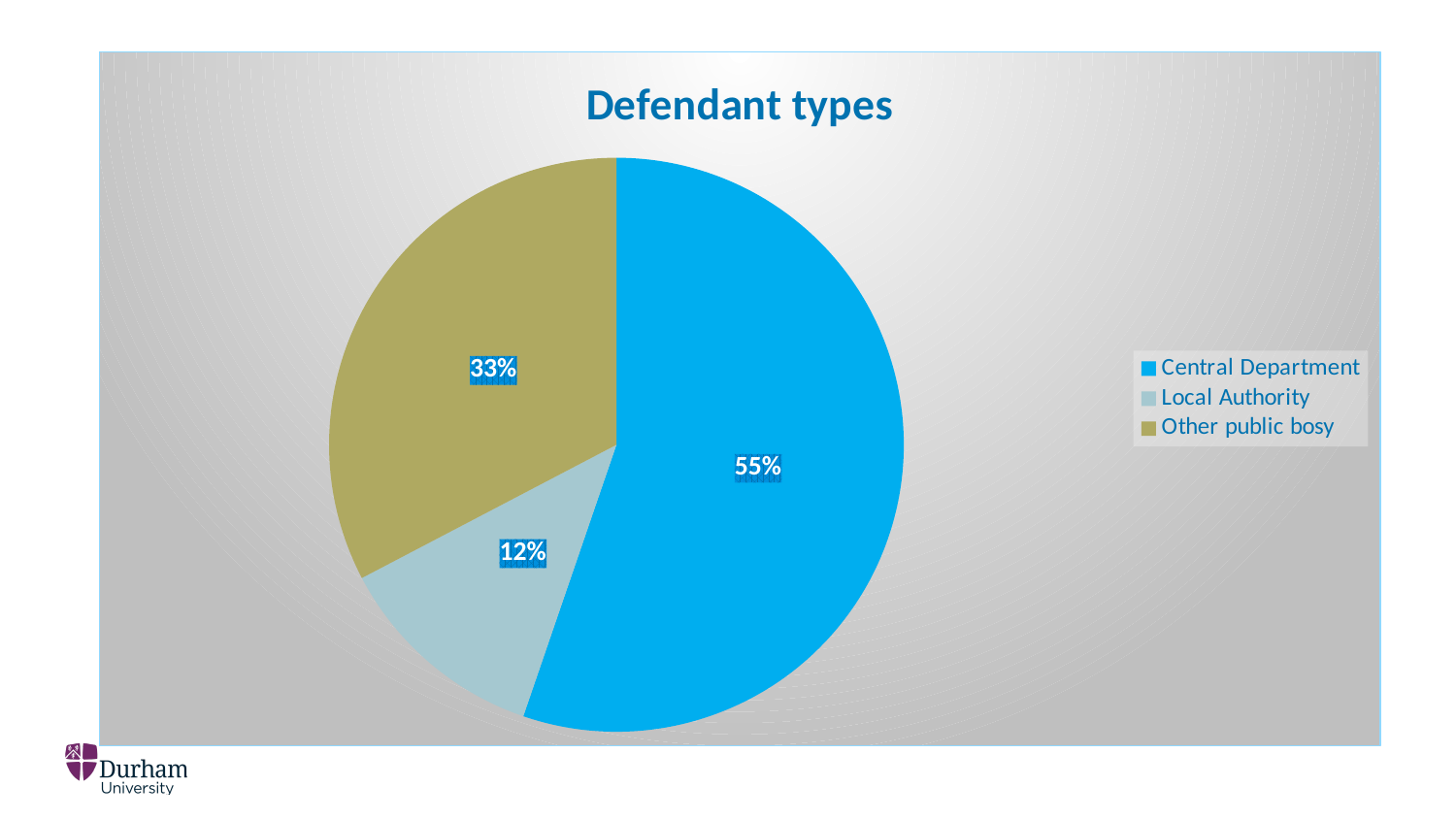
What share of the pie does Other public bosy have? 33% How many slices does the pie chart have? 3 What is the difference in percentage points between Central Department and Other public bosy? 22 Which is larger, the share for Local Authority or the share for Other public bosy? Other public bosy What share of the pie does Local Authority have? 12% What is the difference in percentage points between Other public bosy and Local Authority? 21 Which defendant type has the smallest share? Local Authority Which defendant type has the largest share? Central Department What kind of chart is shown on the slide? Pie chart What is the title of the chart? Defendant types What share of the pie does Central Department have? 55% Which colour represents Other public bosy in the legend? Olive/khaki